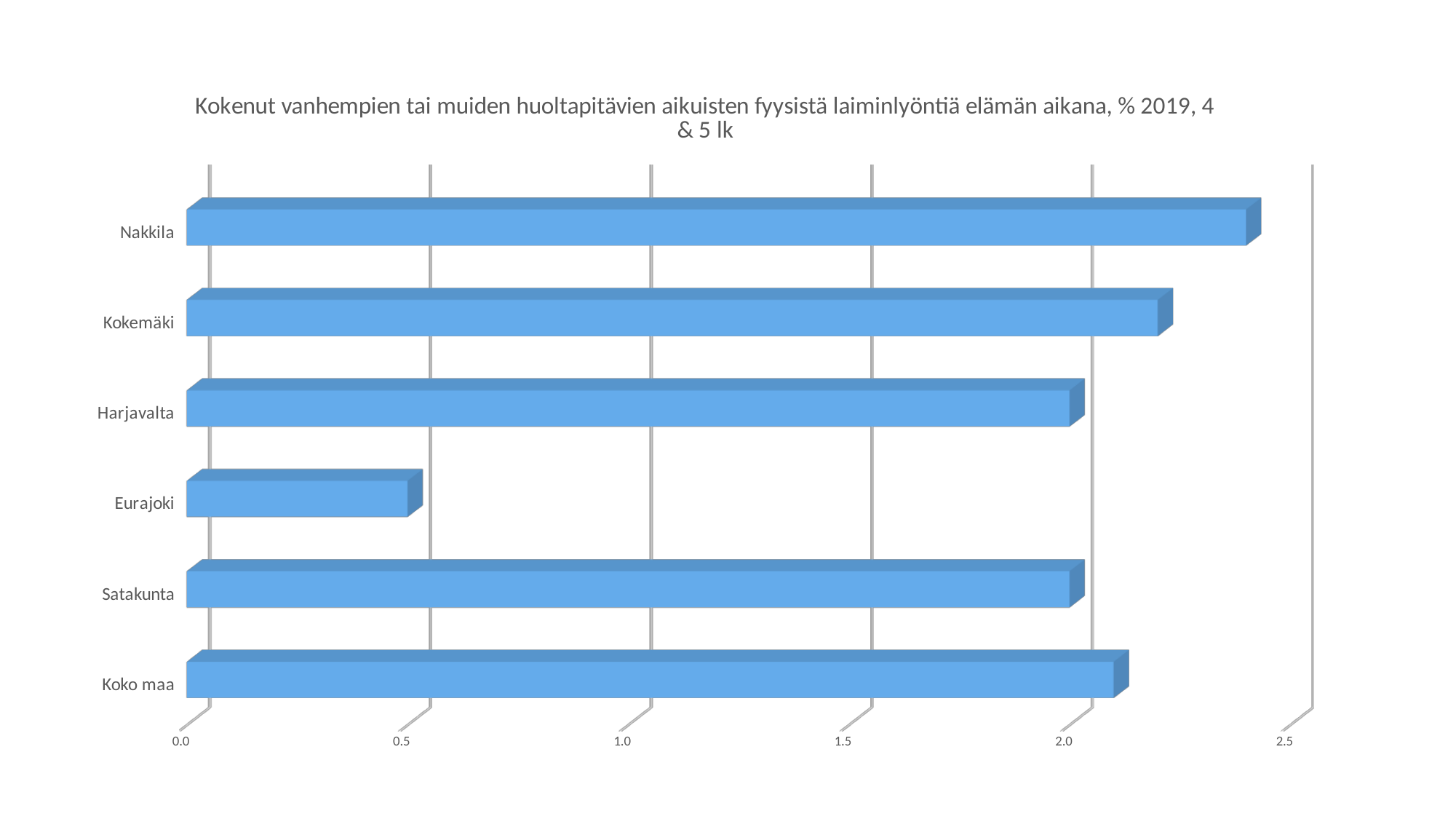
Which has the larger value, Kokemäki or Koko maa? Kokemäki What colour are the bars in the chart? Blue Which has the larger value, Eurajoki or Satakunta? Satakunta Is the value for Nakkila greater or less than 2.0? greater Which category has the highest value? Nakkila Is the value for Eurajoki greater or less than 1.0? less Is the value for Nakkila greater or less than 2.5? less Which has the larger value, Nakkila or Kokemäki? Nakkila Which category has the lowest value? Eurajoki How many categories are shown on the chart? 6 What kind of chart is shown on the slide? Bar chart